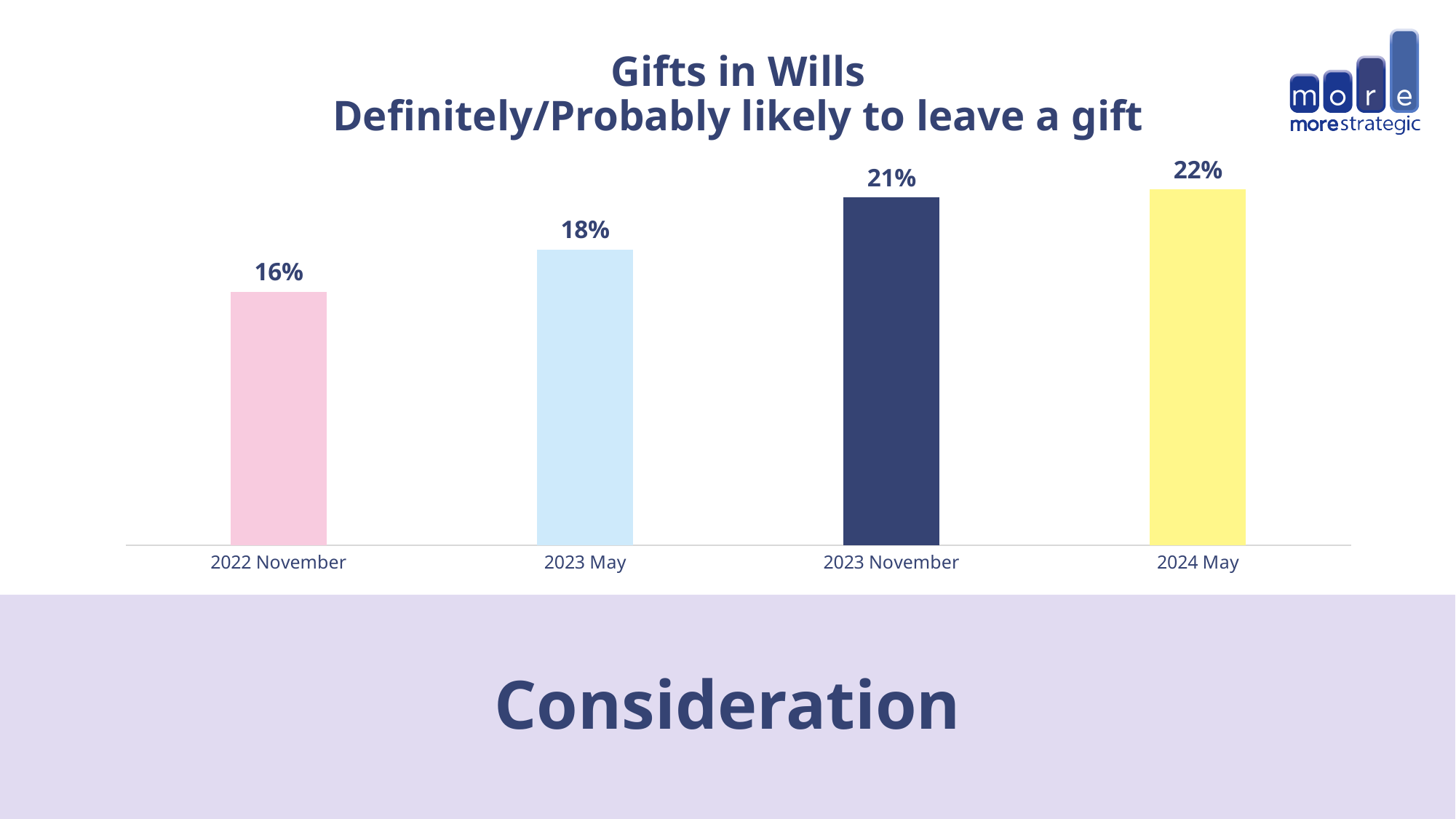
Do the values rise or fall from 2022 November to 2024 May? Rise What is the difference between the values for 2024 May and 2022 November? 6% Which period has the lowest value? 2022 November What is the difference between the values for 2023 November and 2023 May? 3% Which period has the highest value? 2024 May What is the value for 2023 November? 21% What is the value for 2023 May? 18% What is the value for 2024 May? 22% How many periods are shown on the chart? 4 Which is larger, the value for 2023 May or the value for 2023 November? 2023 November What is the value for 2022 November? 16% What kind of chart is shown on the slide? Bar chart